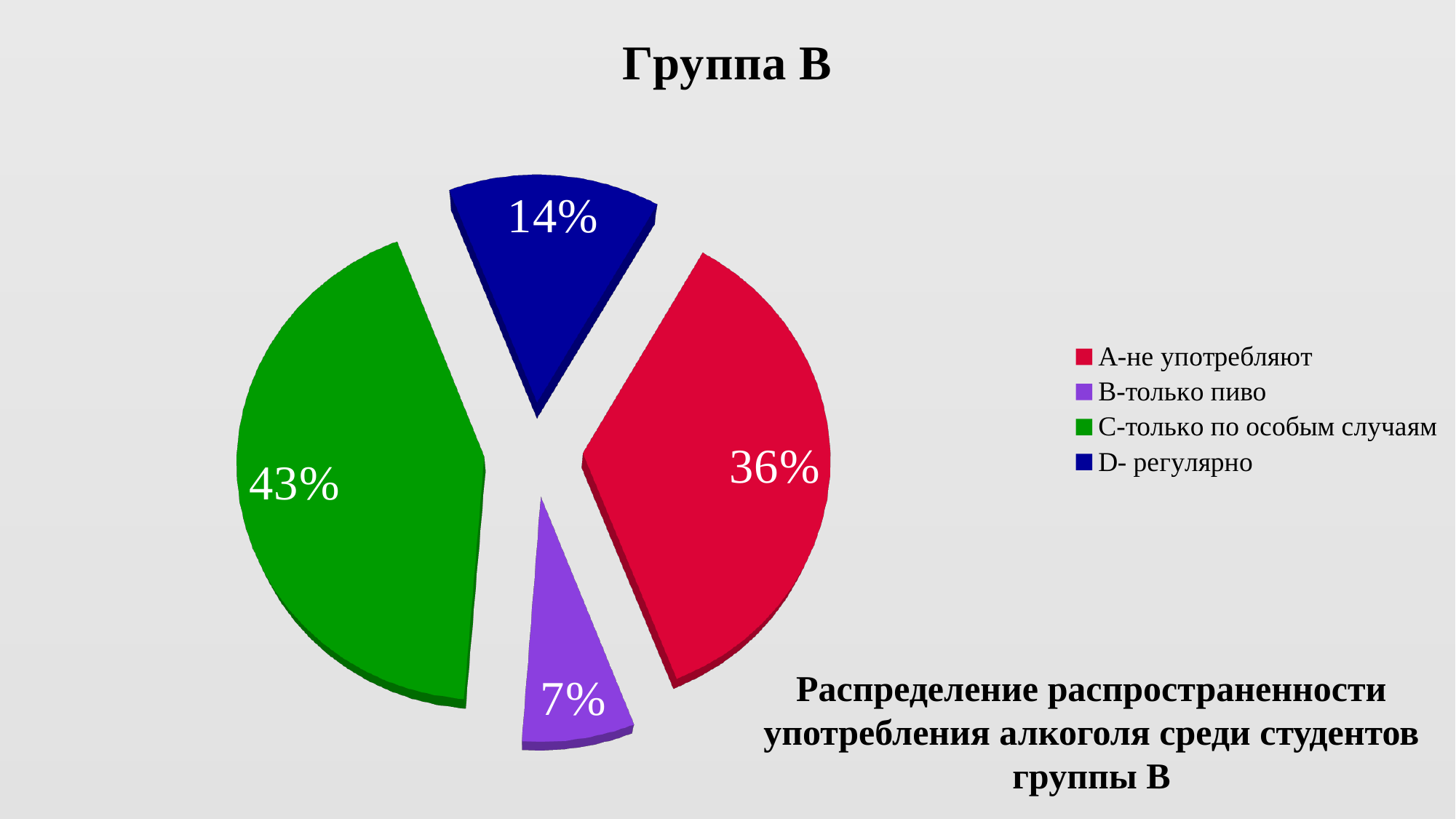
What is the title of the chart? Группа В What is the difference between the values for 'C-только по особым случаям' and 'A-не употребляют'? 7% Which is larger: the value for 'A-не употребляют' or the value for 'D- регулярно'? A-не употребляют What is the difference between the values for 'D- регулярно' and 'B-только пиво'? 7% Which category has the smallest slice of the pie? B-только пиво What kind of chart is shown on the slide? Pie chart Which category has the largest slice of the pie? C-только по особым случаям What is the value shown for 'D- регулярно'? 14% How many categories does the pie chart show? 4 What share of the pie does the slice for 'C-только по особым случаям' represent? 43% What is the value shown for 'A-не употребляют'? 36% What is the value shown for 'B-только пиво'? 7%